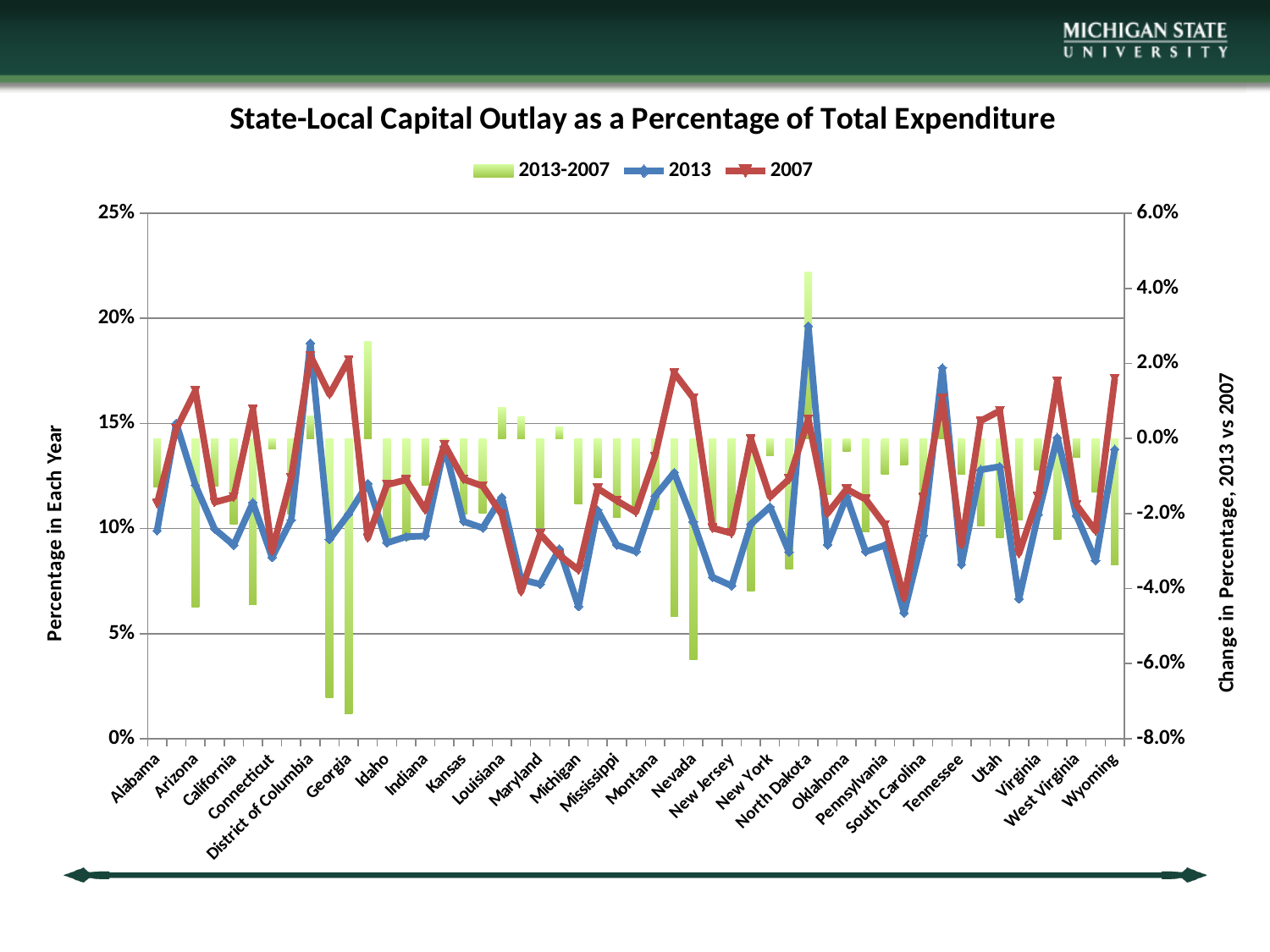
What is the title of the chart? State-Local Capital Outlay as a Percentage of Total Expenditure What kind of chart is this? Combined bar and line chart How many series does the legend list? 3 For Georgia, which is larger: the 2013 value or the 2007 value? 2007 Is the 2007 value for Nevada greater or less than 15%? greater Is the 2013-2007 change for Nevada greater or less than -4.0%? less Which state has the highest value in the 2013 series? North Dakota For North Dakota, which is larger: the 2013 value or the 2007 value? 2013 Which state has the highest 2013-2007 change bar? North Dakota Is the 2013 value for North Dakota greater or less than 15%? greater